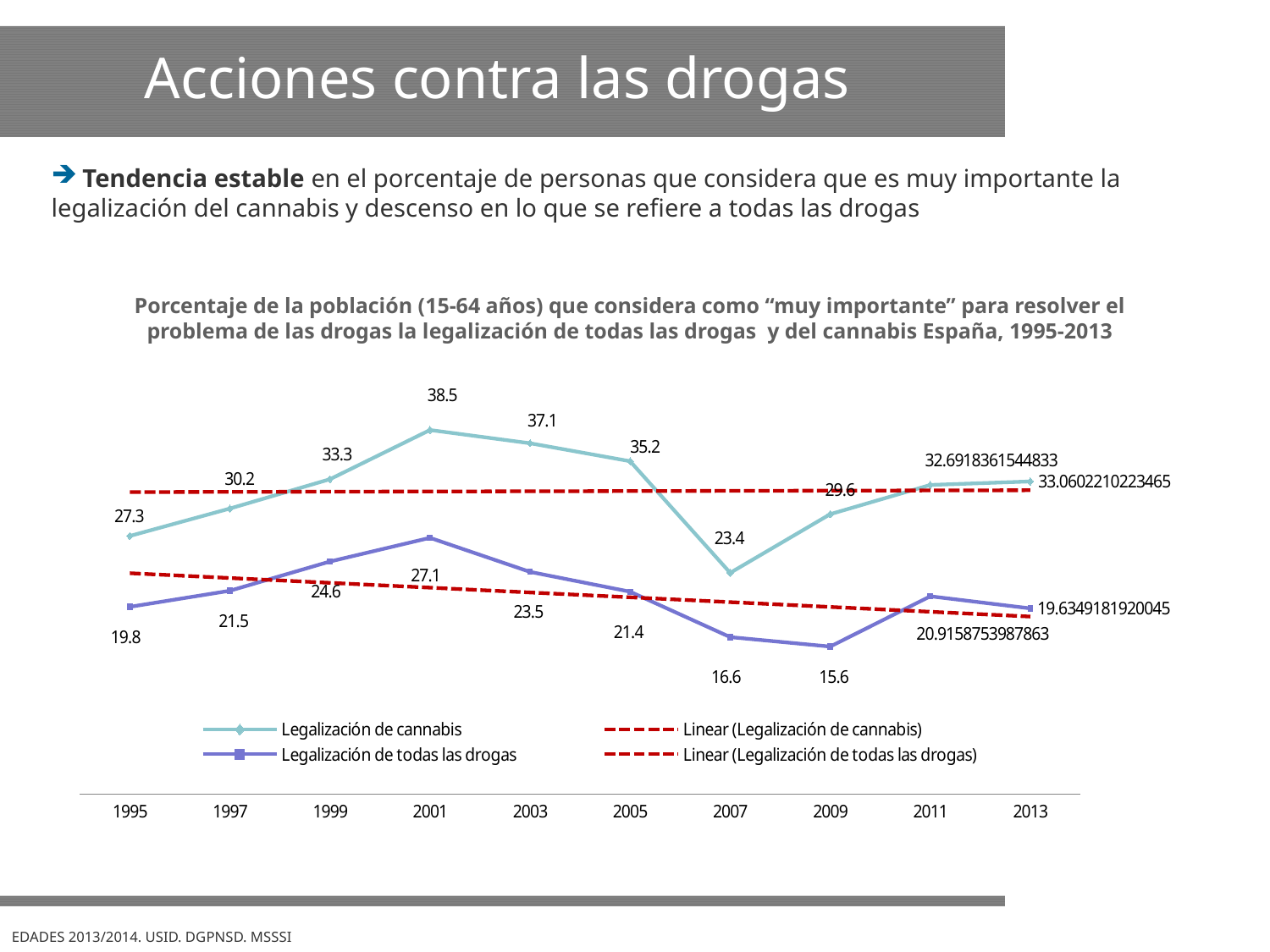
What is the value for Legalización de cannabis in 2001? 38.5 What is the value for Legalización de todas las drogas in 2009? 15.6 How many entries does the legend list? 4 What is the difference between Legalización de cannabis and Legalización de todas las drogas in 1995? 7.5 What is the value for Legalización de cannabis in 2007? 23.4 In which year does Legalización de cannabis reach its highest value? 2001 Does Legalización de cannabis rise or fall between 2005 and 2007? Fall In which year does Legalización de todas las drogas reach its lowest value? 2009 What kind of chart is shown on the slide? Line chart How many years are shown on the x axis? 10 Which is larger in 2005: Legalización de cannabis or Legalización de todas las drogas? Legalización de cannabis What is the difference between the 2001 and 2003 values for Legalización de todas las drogas? 3.6